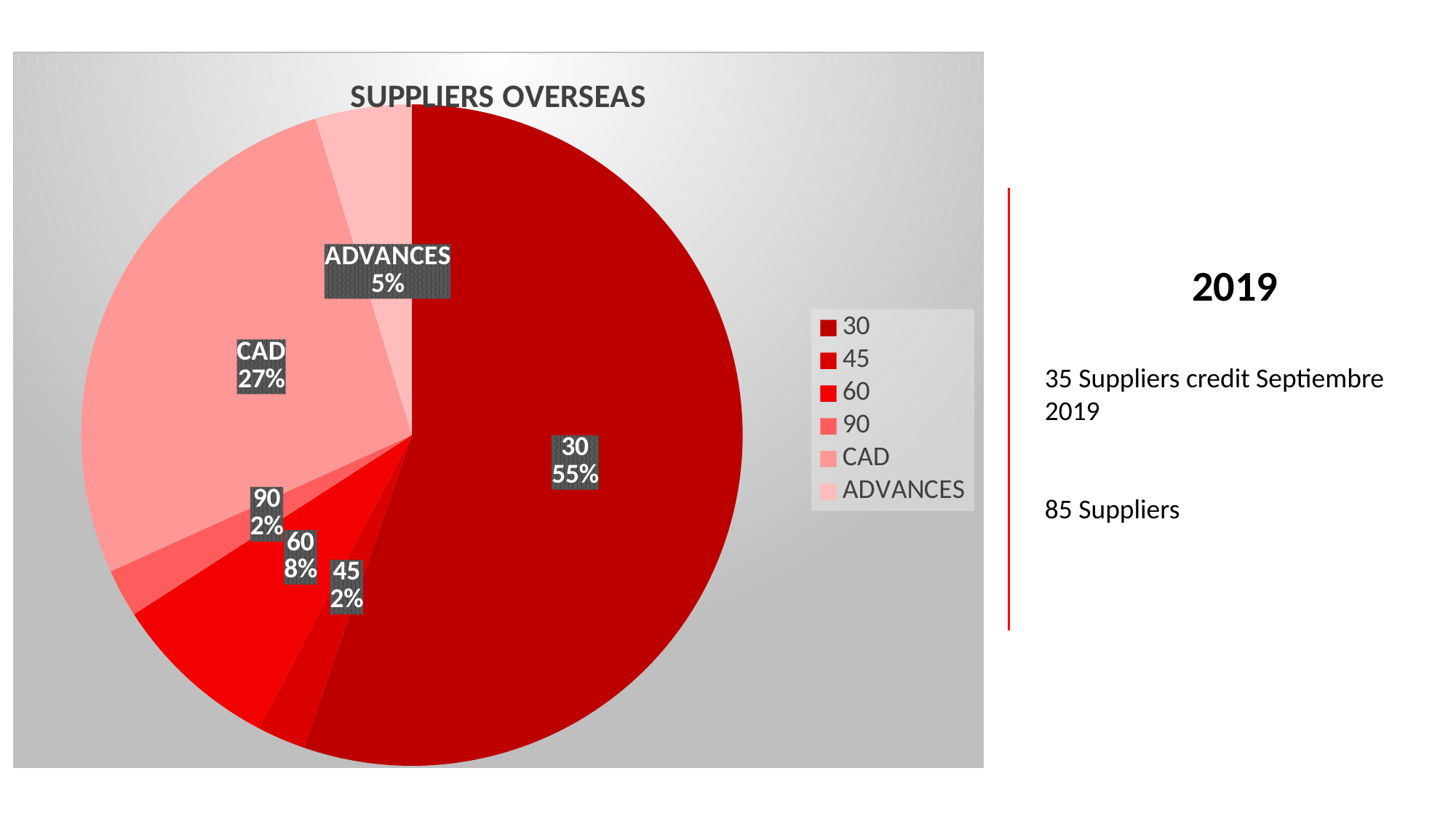
Which is larger, the 60 slice or the ADVANCES slice? 60 What share of the pie does the 60 slice represent? 8% What is the title of the chart? SUPPLIERS OVERSEAS What is the difference in percentage points between the 30 slice and the CAD slice? 28 What share of the pie does the CAD slice represent? 27% What share of the pie does the ADVANCES slice represent? 5% How many slices does the pie chart have? 6 Which slice is the largest in the pie chart? 30 How many entries does the legend list? 6 What kind of chart is shown on the slide? pie chart